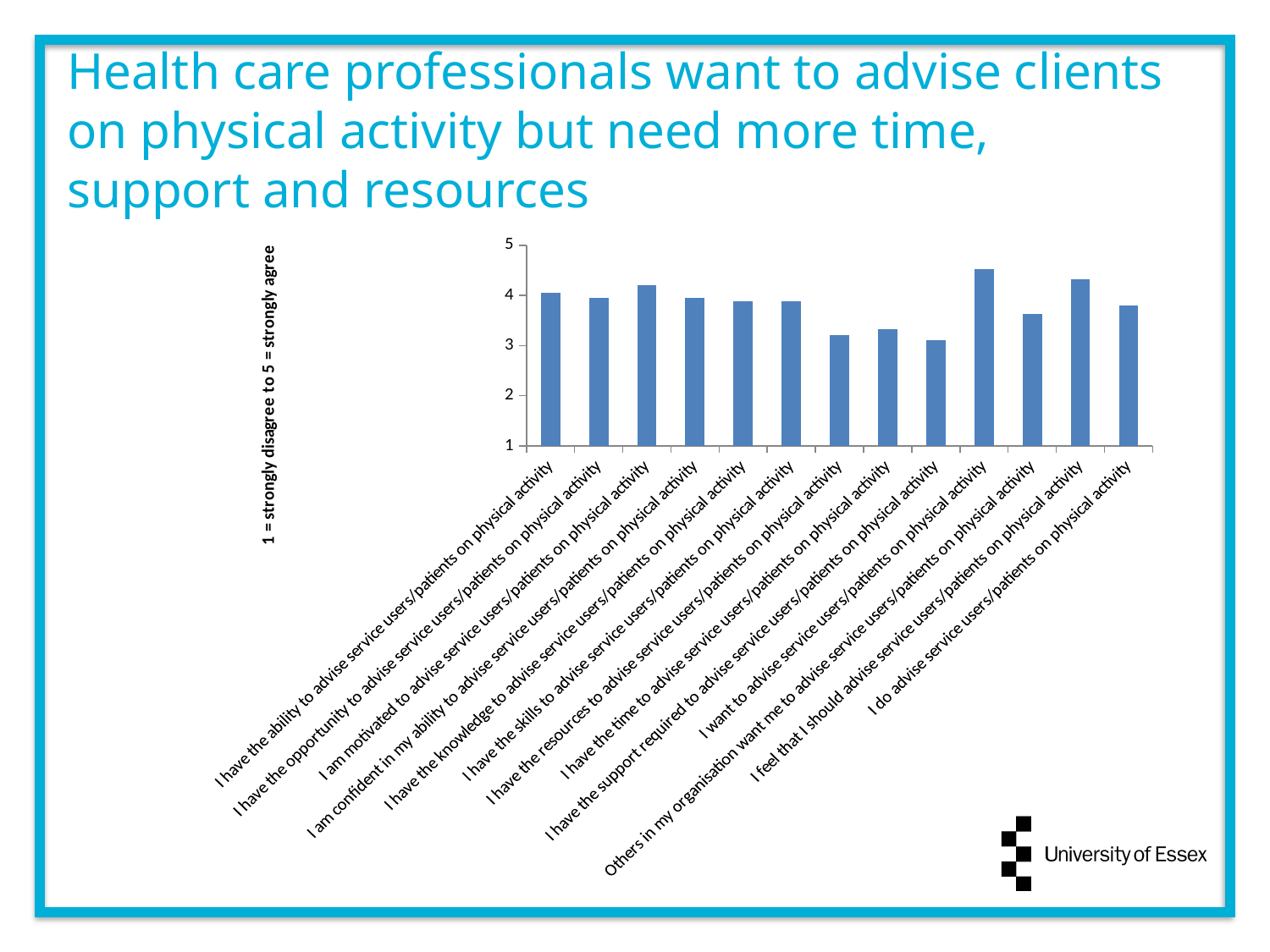
What kind of chart is shown on the slide? bar chart Which is larger: the value for 'I want to advise service users/patients on physical activity' or for 'I have the resources to advise service users/patients on physical activity'? I want to advise service users/patients on physical activity What does the y-axis label say the scale runs from and to? 1 = strongly disagree to 5 = strongly agree How many bars (statements) are plotted in the chart? 13 Is the value for 'I feel that I should advise service users/patients on physical activity' greater or less than 4? greater Is the value for 'I want to advise service users/patients on physical activity' greater or less than 4? greater What is the lowest value shown on the y-axis? 1 Is the value for 'Others in my organisation want me to advise service users/patients on physical activity' greater or less than 4? less Which statement has the highest average agreement score? I want to advise service users/patients on physical activity Which is larger: the value for 'I am motivated to advise service users/patients on physical activity' or for 'I have the time to advise service users/patients on physical activity'? I am motivated to advise service users/patients on physical activity